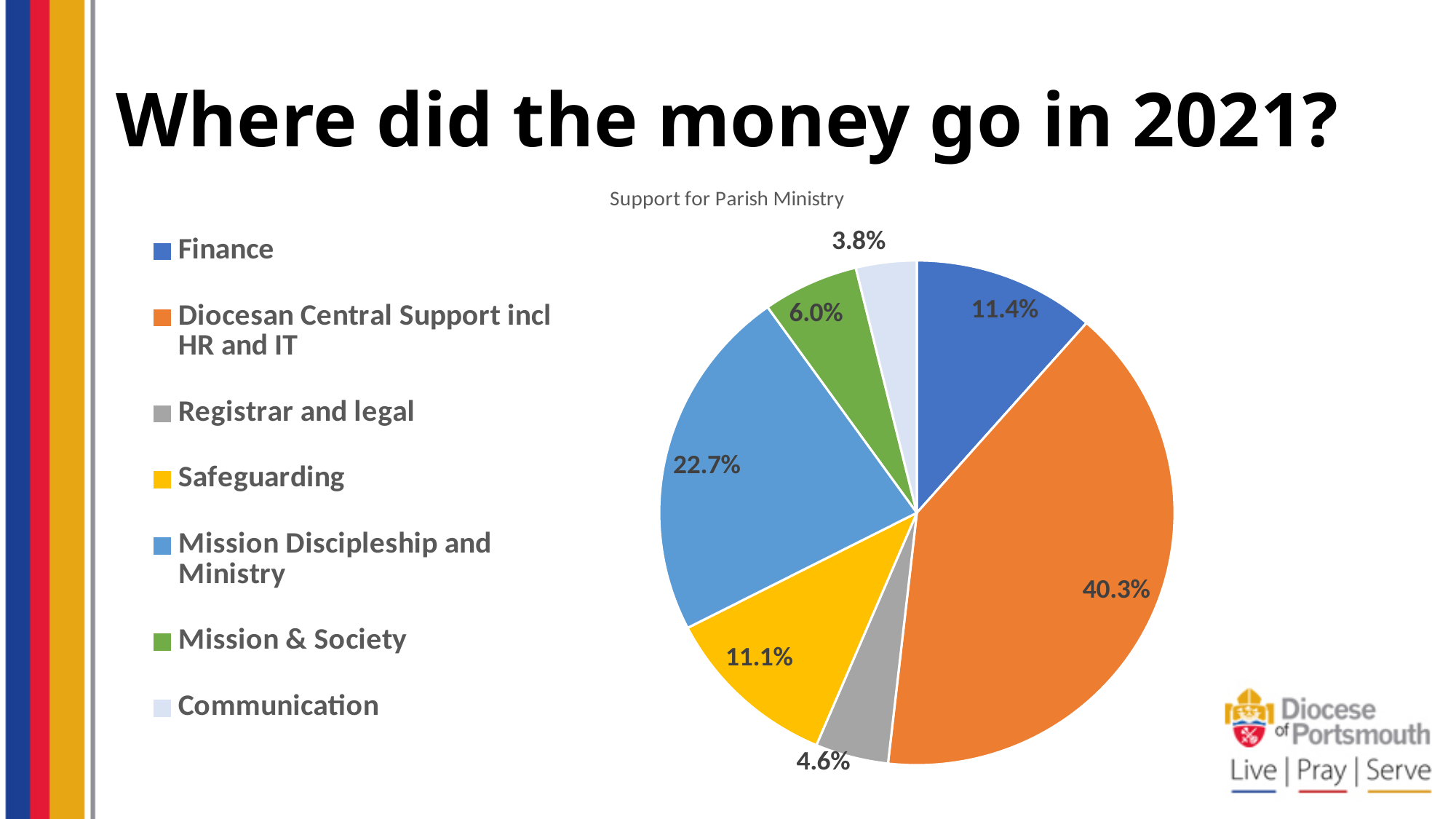
What share of the pie does Diocesan Central Support incl HR and IT represent? 40.3% What share of the pie does Registrar and legal represent? 4.6% What is the difference in percentage points between Mission Discipleship and Ministry and Mission & Society? 16.7 What share of the pie does Mission Discipleship and Ministry represent? 22.7% Which category has the smallest share of the pie? Communication What is the title of the chart? Support for Parish Ministry Which category has the largest share of the pie? Diocesan Central Support incl HR and IT What type of chart is shown on the slide? pie chart How many categories does the pie chart show? 7